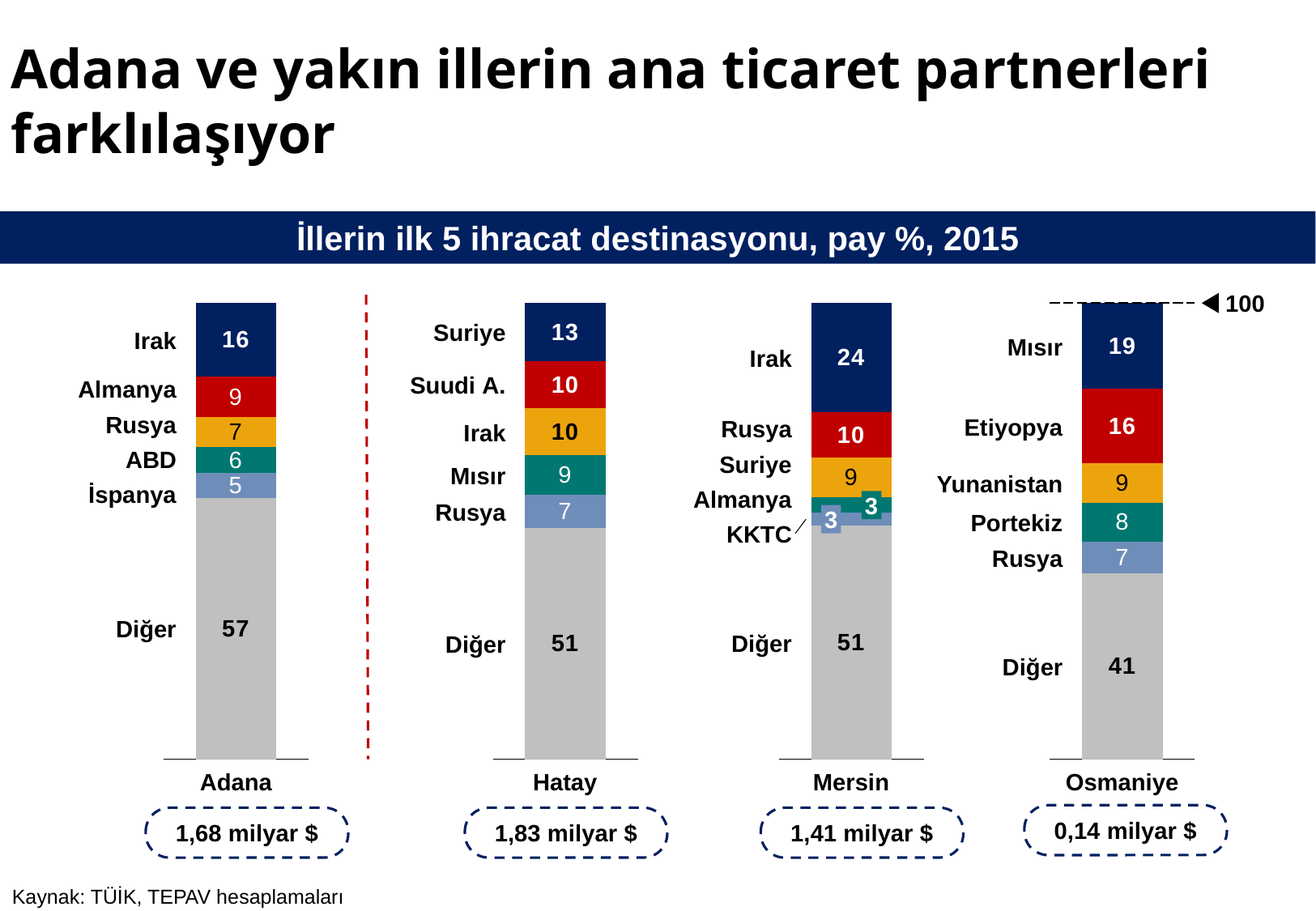
Which province has the lowest Diğer (other) share? Osmaniye What is the share of Suriye in Hatay's exports? 13 What is the total export value shown for Hatay? 1,83 milyar $ What is the title of the chart? İllerin ilk 5 ihracat destinasyonu, pay %, 2015 What kind of chart is shown on the slide? Stacked bar chart What is the share of Irak in Adana's exports? 16 How many provinces are shown as stacked bars in the chart? 4 Which is larger: the Mısır share in Osmaniye or the Mısır share in Hatay? Osmaniye Which province has the highest share for Irak among its top destinations? Mersin What is the total of the Adana stacked bar? 100 What is the difference between the Irak share in Mersin and the Irak share in Adana? 8 What is the share of Diğer (other) in Osmaniye's exports? 41